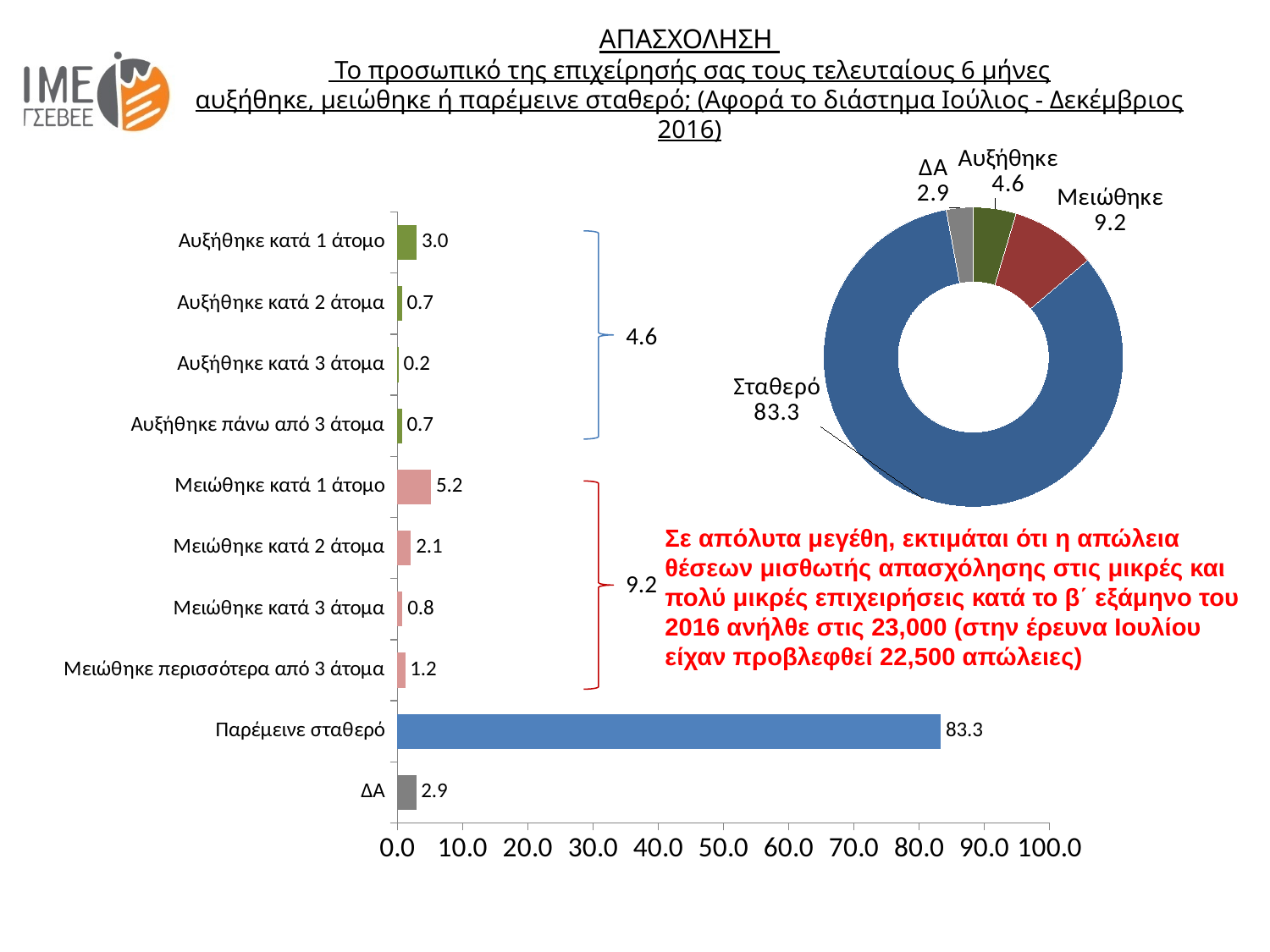
How many slices does the doughnut chart on the right have? 4 In the doughnut chart on the right, what is the value for 'Μειώθηκε'? 9.2 In the bar chart on the left, which category has the highest value? Παρέμεινε σταθερό What kind of chart is the chart on the left of the slide? Bar chart In the bar chart on the left, what is the value for 'Αυξήθηκε κατά 3 άτομα'? 0.2 In the bar chart on the left, what is the value for 'Μειώθηκε κατά 1 άτομο'? 5.2 In the bar chart on the left, what is the value for 'Παρέμεινε σταθερό'? 83.3 In the bar chart on the left, which category has the lowest value? Αυξήθηκε κατά 3 άτομα In the bar chart on the left, which is larger: 'Μειώθηκε κατά 2 άτομα' or 'Μειώθηκε περισσότερα από 3 άτομα'? Μειώθηκε κατά 2 άτομα How many categories does the bar chart on the left show? 10 In the doughnut chart on the right, what is the value for 'Σταθερό'? 83.3 In the bar chart on the left, what is the difference between 'Μειώθηκε κατά 1 άτομο' and 'Αυξήθηκε κατά 1 άτομο'? 2.2